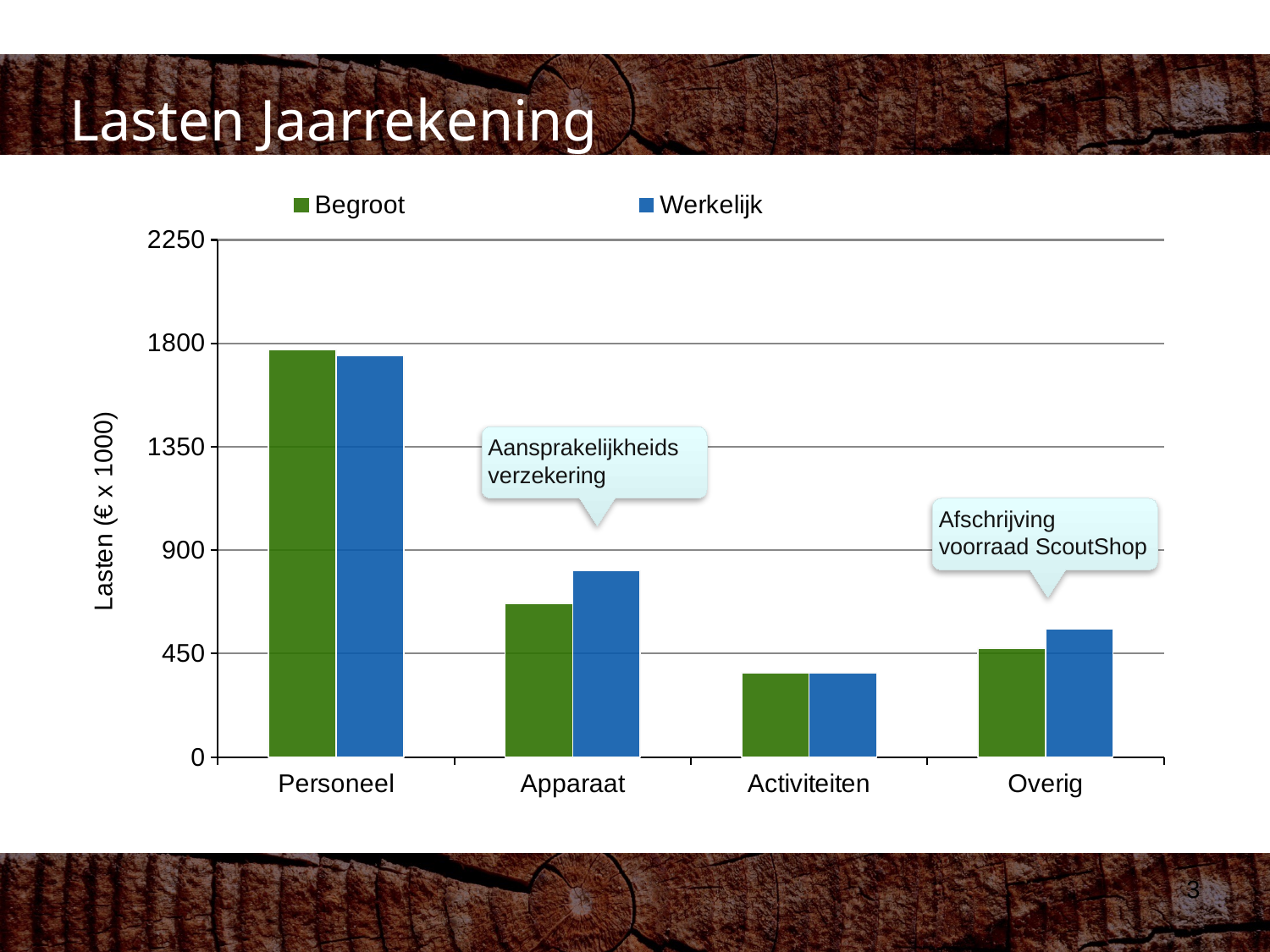
Is the Werkelijk value for Personeel greater or less than 1350? greater Is the Begroot value for Activiteiten greater or less than 450? less How many categories are shown on the x axis? 4 How many series does the legend list? 2 Which category has the lowest Werkelijk value? Activiteiten For Overig, which is larger: Begroot or Werkelijk? Werkelijk Is the Werkelijk value for Apparaat greater or less than 900? less For Apparaat, which is larger: Begroot or Werkelijk? Werkelijk Which series is shown in blue? Werkelijk What kind of chart is shown on the slide? bar chart What is the label on the vertical axis? Lasten (€ x 1000) Which category has the highest Begroot value? Personeel